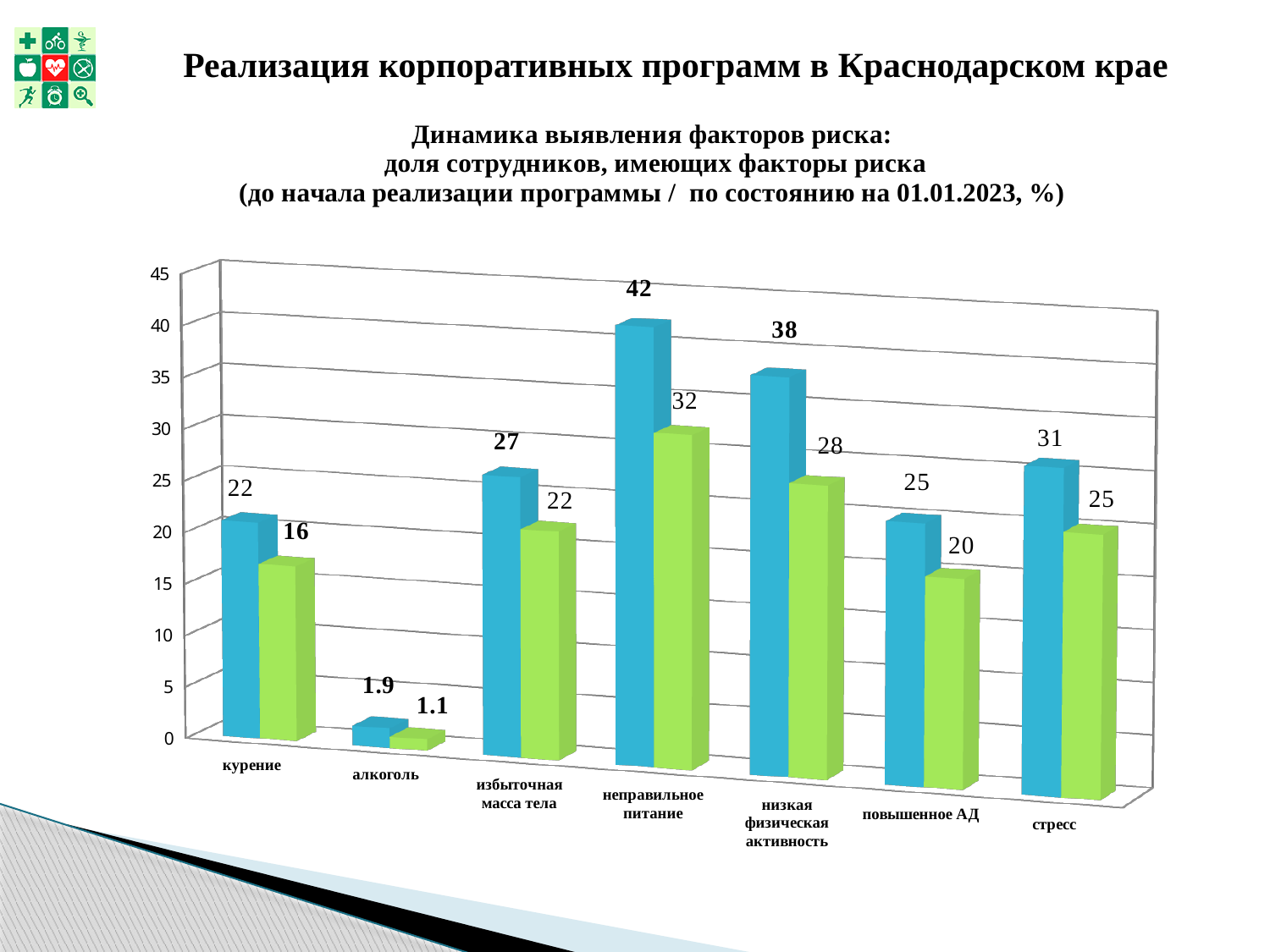
What is the maximum value shown on the vertical axis? 45 What is the value of the blue bar for «неправильное питание»? 42 Which risk factor has the highest blue bar? неправильное питание What is the difference between the blue and green bars for «низкая физическая активность»? 10 How many risk factor categories are shown on the x axis? 7 Which is larger: the blue bar for «стресс» or the blue bar for «повышенное АД»? стресс What kind of chart is shown on the slide? bar chart Is the green bar for «избыточная масса тела» greater or less than 25? less What is the value of the green bar for «курение»? 16 Which risk factor has the lowest green bar? алкоголь What is the value of the green bar for «стресс»? 25 What is the value of the blue bar for «алкоголь»? 1.9